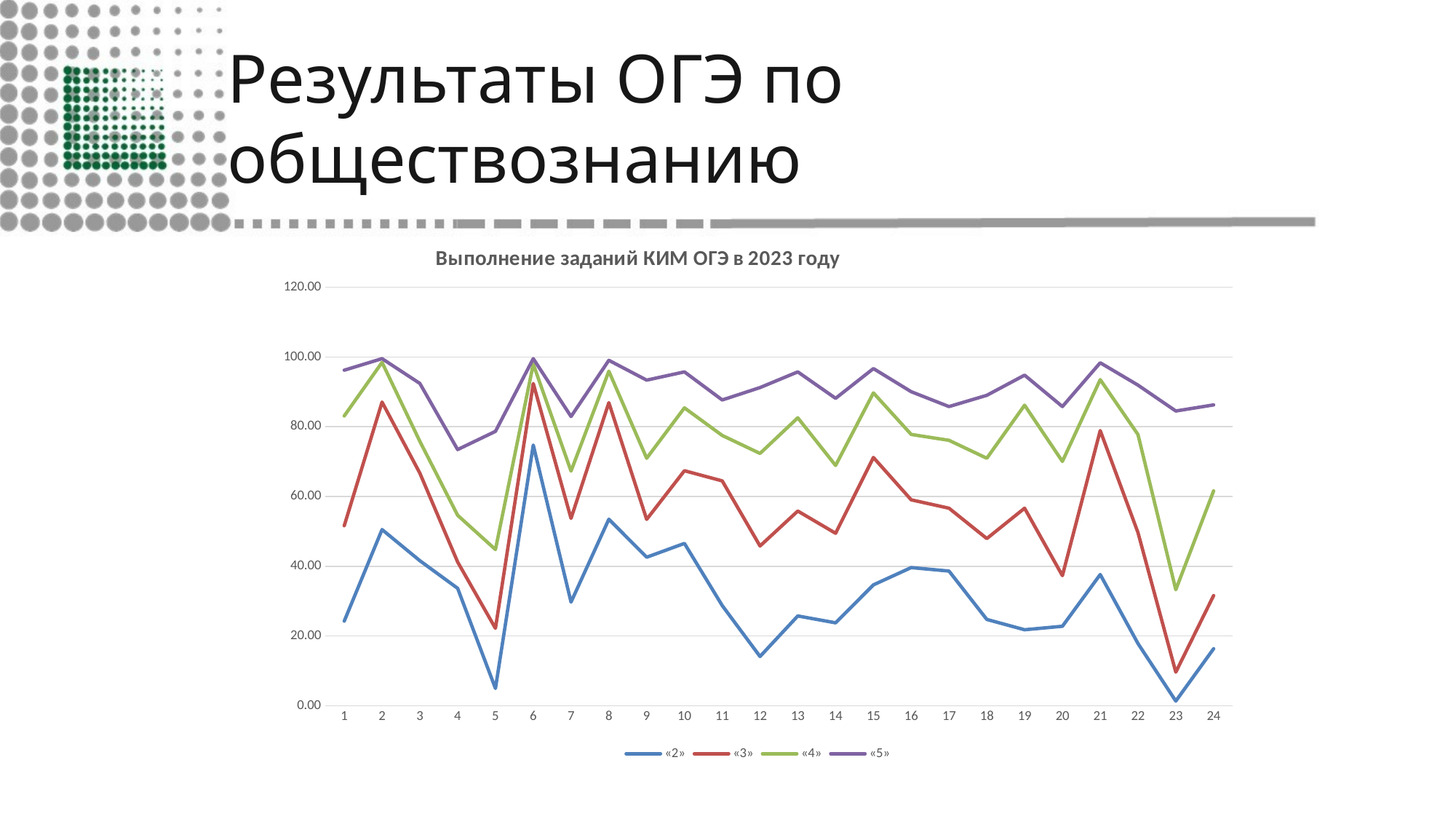
Is the value of series «2» at point 6 greater or less than 60? greater Is the value of series «2» at point 5 greater or less than 20? less At which point does series «2» reach its highest value? 6 How many series does the legend list? 4 At which point does series «4» reach its lowest value? 23 What is the title of the chart? Выполнение заданий КИМ ОГЭ в 2023 году Which series has the highest value at point 1? «5» What kind of chart is shown on the slide? line chart Does series «3» rise or fall from point 21 to point 23? fall Is the value of series «5» at point 2 greater or less than 80? greater How many points are plotted along the x axis? 24